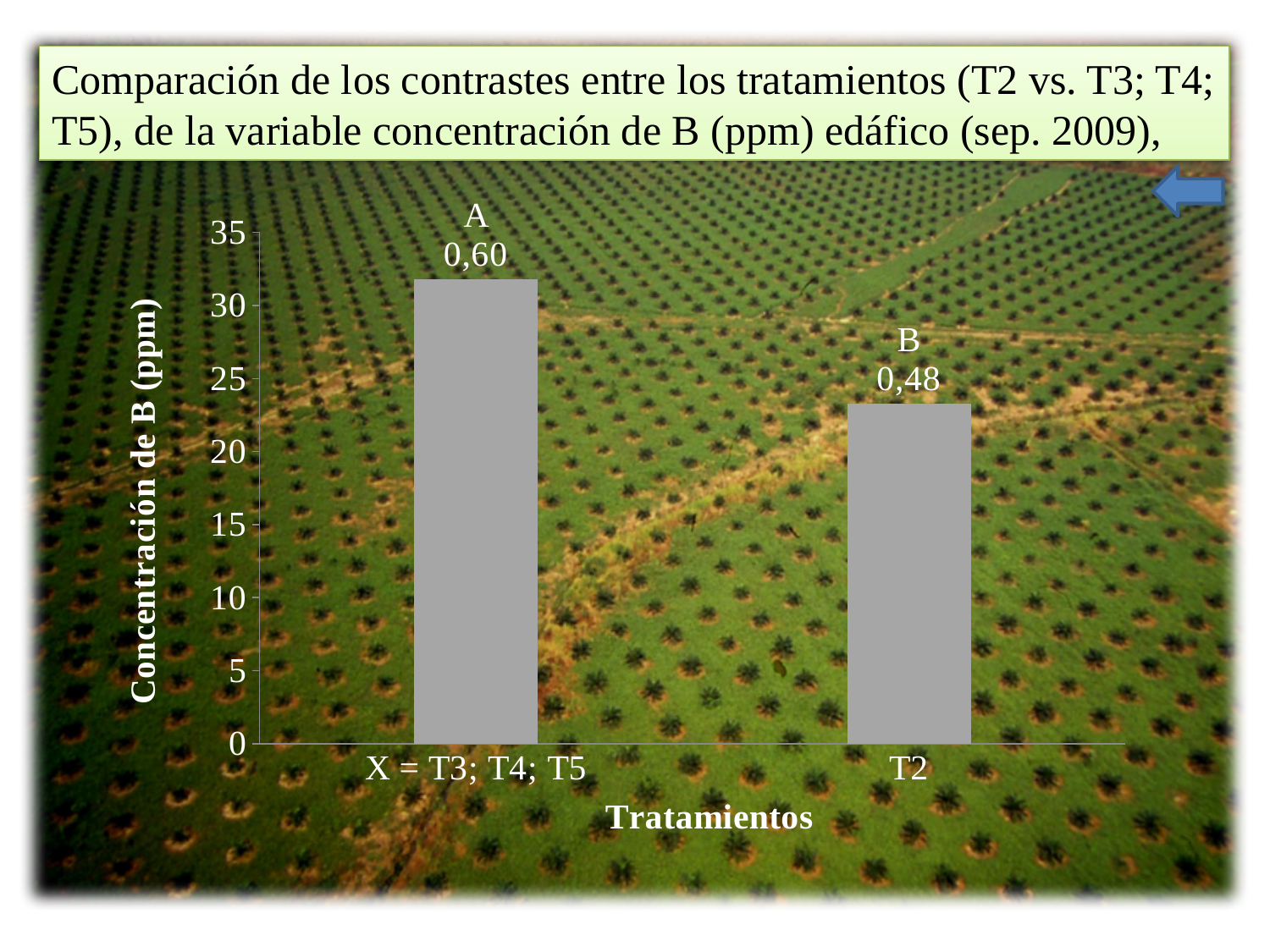
Which category has the shorter bar? T2 On the y axis, is the bar for T2 greater or less than 25? less On the y axis, is the bar for X = T3; T4; T5 greater or less than 30? greater What is the difference between the printed values 0,60 and 0,48? 0,12 Is the bar for X = T3; T4; T5 taller or shorter than the bar for T2? taller What is the label of the y axis? Concentración de B (ppm) Which category has the taller bar? X = T3; T4; T5 What value is printed above the bar for X = T3; T4; T5? 0,60 What type of chart is shown on the slide? bar chart How many bars (categories) are plotted in the chart? 2 What letter is printed above the bar for T2? B What value is printed above the bar for T2? 0,48